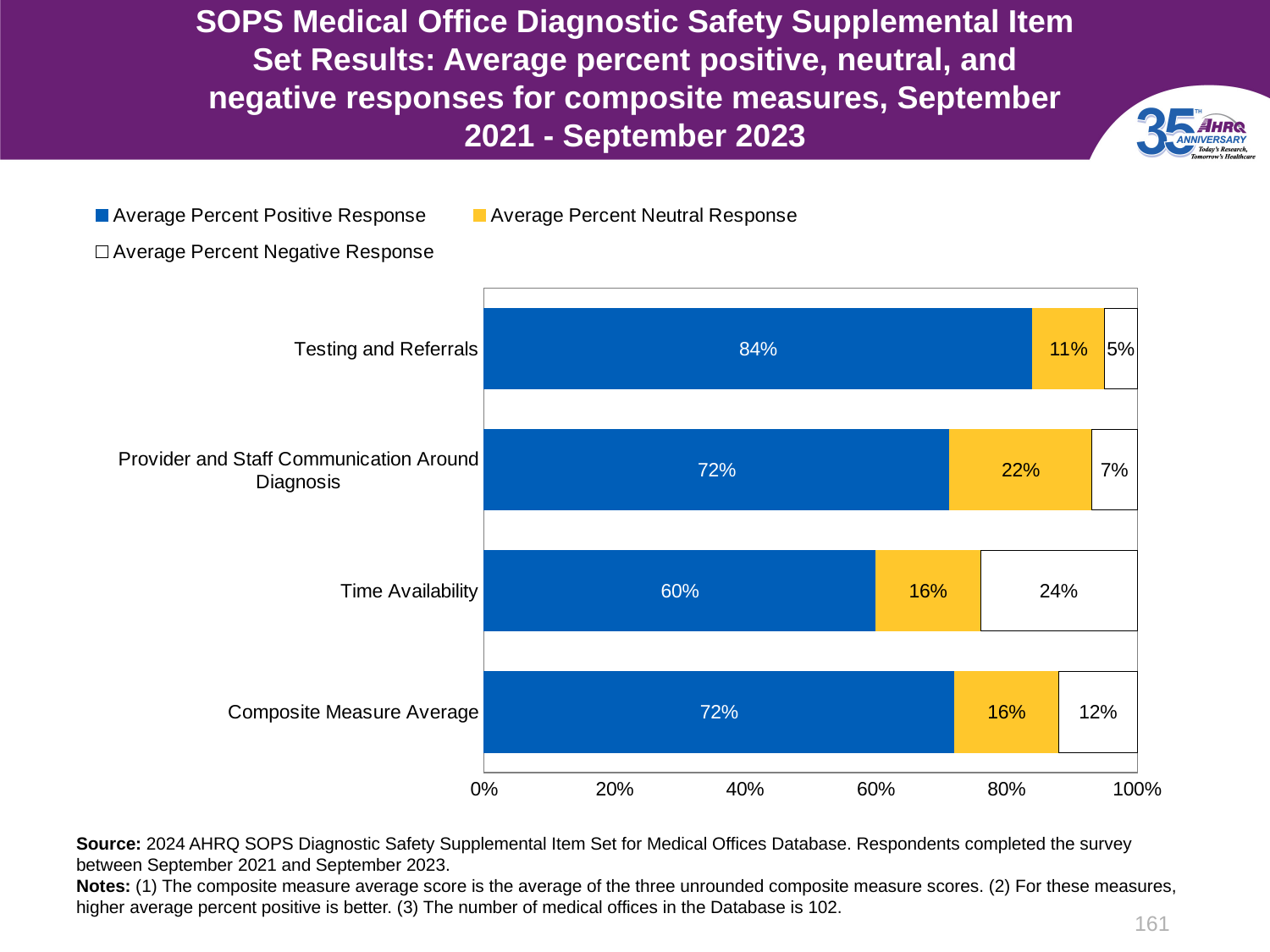
What is the difference between the Average Percent Positive Response for Testing and Referrals and for Time Availability? 24% What is the Average Percent Positive Response for Testing and Referrals? 84% What kind of chart is shown on the slide? Stacked bar chart Which composite measure has the highest Average Percent Positive Response? Testing and Referrals How many series does the legend list? 3 How many composite measure categories are shown on the chart? 4 What is the Average Percent Negative Response for Time Availability? 24% What colour represents the Average Percent Neutral Response in the chart? Yellow Which is larger: the Average Percent Negative Response for Time Availability or for Testing and Referrals? Time Availability What is the Average Percent Positive Response for the Composite Measure Average? 72% What is the Average Percent Neutral Response for Provider and Staff Communication Around Diagnosis? 22% Which composite measure has the lowest Average Percent Positive Response? Time Availability